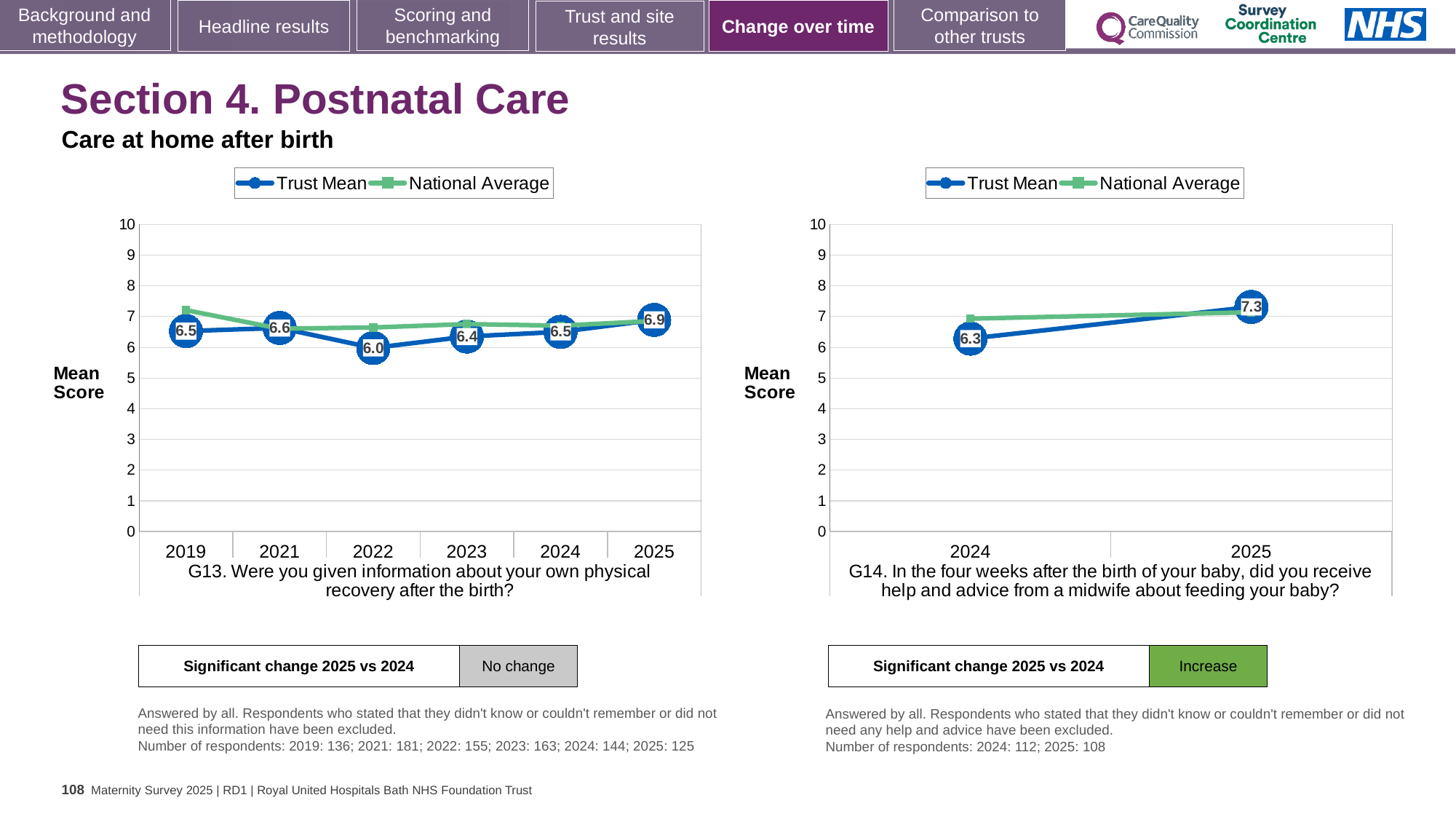
In the G13 chart on the left, what is the Trust Mean score for 2025? 6.9 What type of chart is the G14 chart on the right? line chart In the G13 chart on the left, is the Trust Mean score for 2022 higher or lower than the score for 2023? lower In the G13 chart on the left, what is the Trust Mean score for 2022? 6.0 How many years are shown on the x axis of the G13 chart on the left? 6 In the G13 chart on the left, which year has the highest Trust Mean score? 2025 In the G13 chart on the left, what is the difference between the Trust Mean scores for 2025 and 2022? 0.9 In the G13 chart on the left, is the National Average for 2019 greater or less than 7? greater In the G14 chart on the right, what is the difference between the Trust Mean scores for 2025 and 2024? 1.0 In the G13 chart on the left, which year has the lowest Trust Mean score? 2022 In the G14 chart on the right, what is the Trust Mean score for 2024? 6.3 How many series does the legend of the G14 chart on the right list? 2